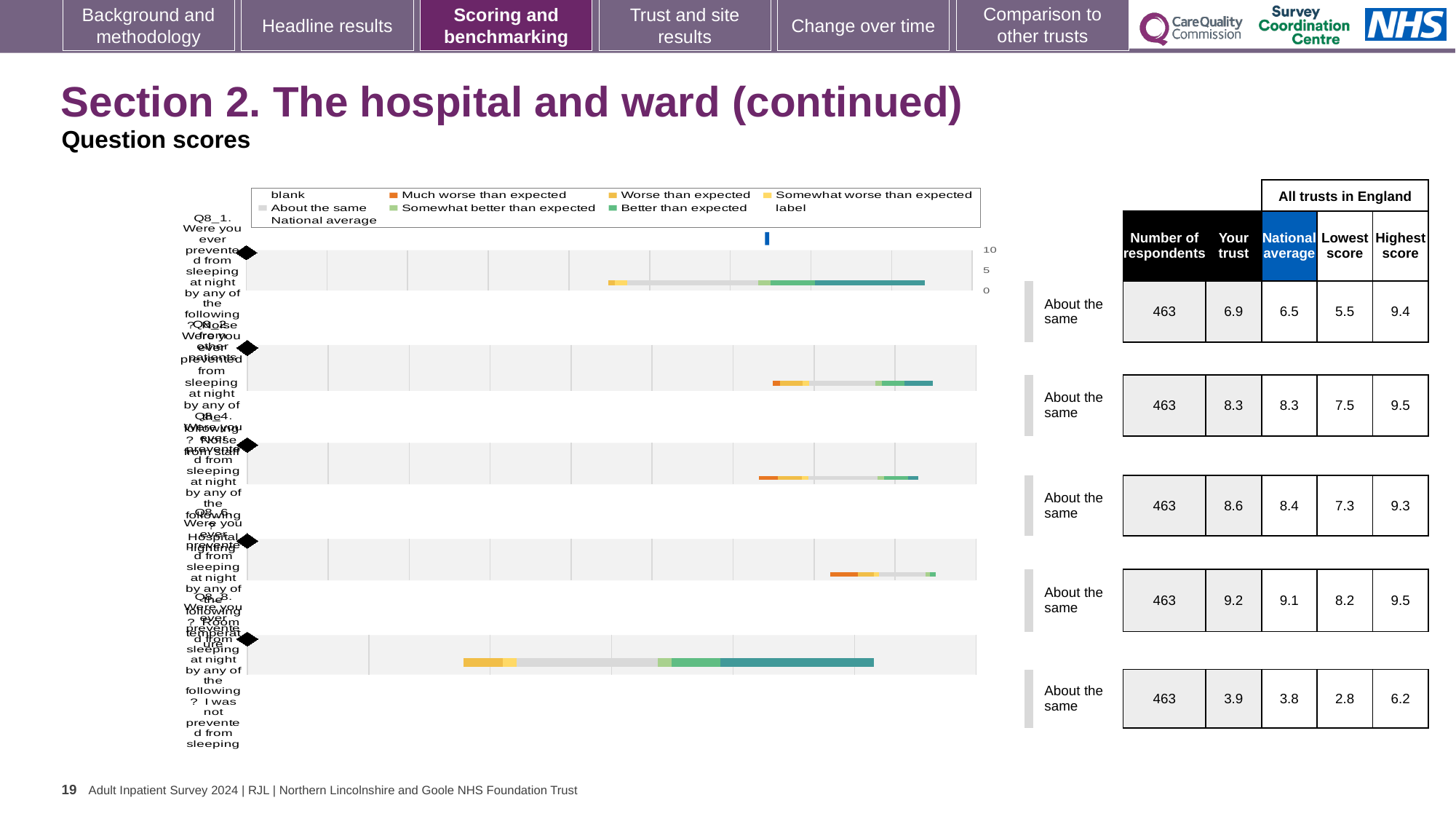
What benchmark label is shown next to the fifth (bottom) row? About the same What is the title of the slide section containing the chart? Section 2. The hospital and ward (continued) What is the 'Your trust' score for the first row (Q8_1)? 6.9 Which row has the lowest 'Your trust' score? the fifth (bottom) row (3.9) For the first row, which is larger: the 'Your trust' score or the national average? Your trust What is the highest score among all trusts in England for the fifth (bottom) row? 6.2 For the first row, what is the difference between the highest score and the lowest score among all trusts in England? 3.9 Which row has the highest 'Your trust' score? the fourth row (9.2) What is the number of respondents shown for the first row? 463 What kind of chart is shown on the slide? bar chart How many question rows (bars) are plotted in the chart? 5 What is the national average for the first row (Q8_1)? 6.5